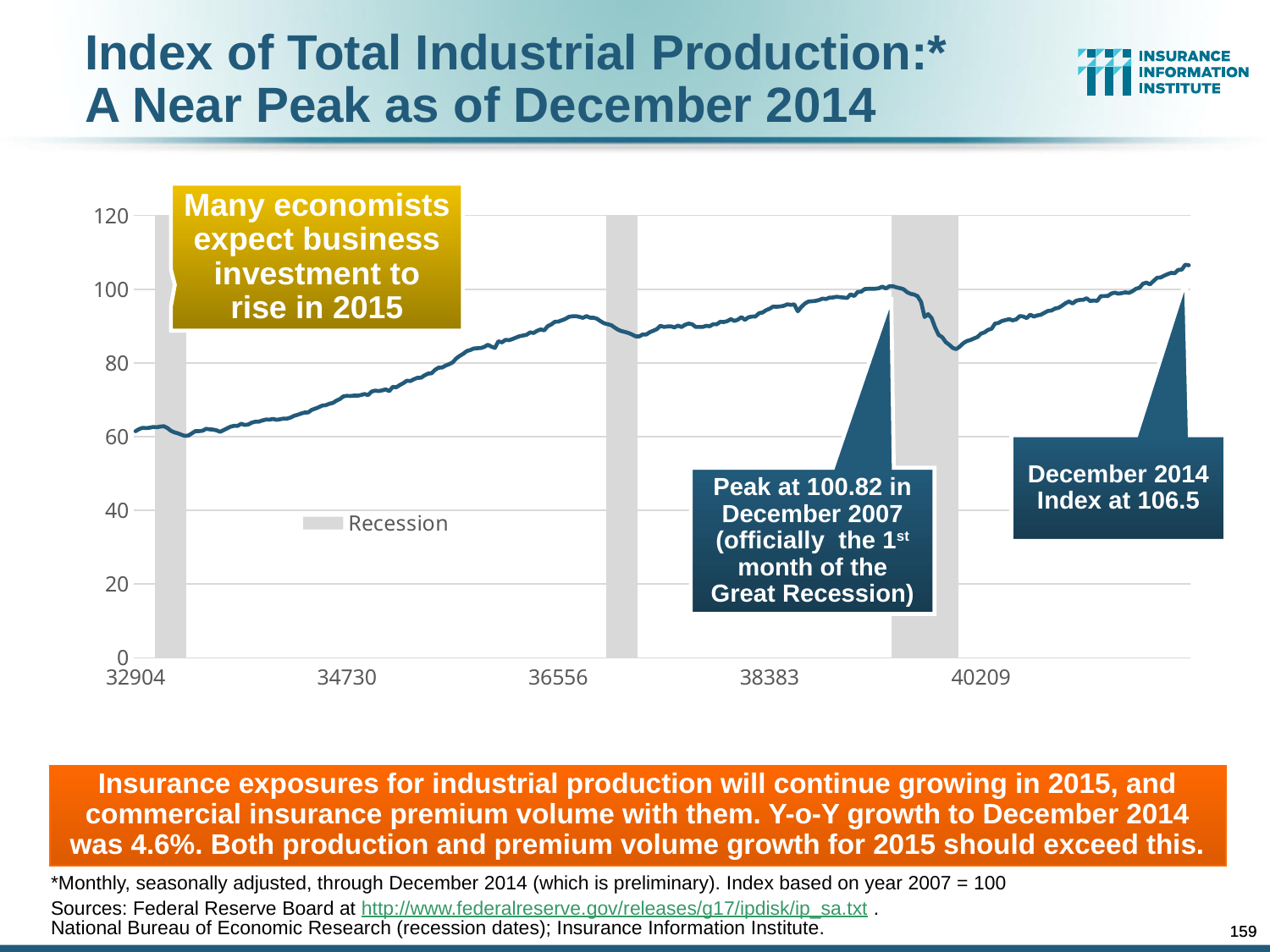
Is the index value at the far right of the chart greater or less than 100? greater What is the highest value labeled on the y axis? 120 What does the gray shading on the chart represent, according to the legend? Recession What kind of chart is shown on the slide? line chart Is the lowest point of the index after the December 2007 peak greater or less than 100? less What was the peak value of the index in December 2007, according to the callout? 100.82 By how much does the December 2014 index value exceed the December 2007 peak? 5.68 Is the index value at the far left of the chart greater or less than 80? less How many shaded recession periods are shown on the chart? 3 Which is higher: the index in December 2014 or the peak in December 2007? December 2014 What was the Index of Total Industrial Production in December 2014, according to the callout? 106.5 Over the whole period shown, does the index generally rise or fall along the x axis? rise